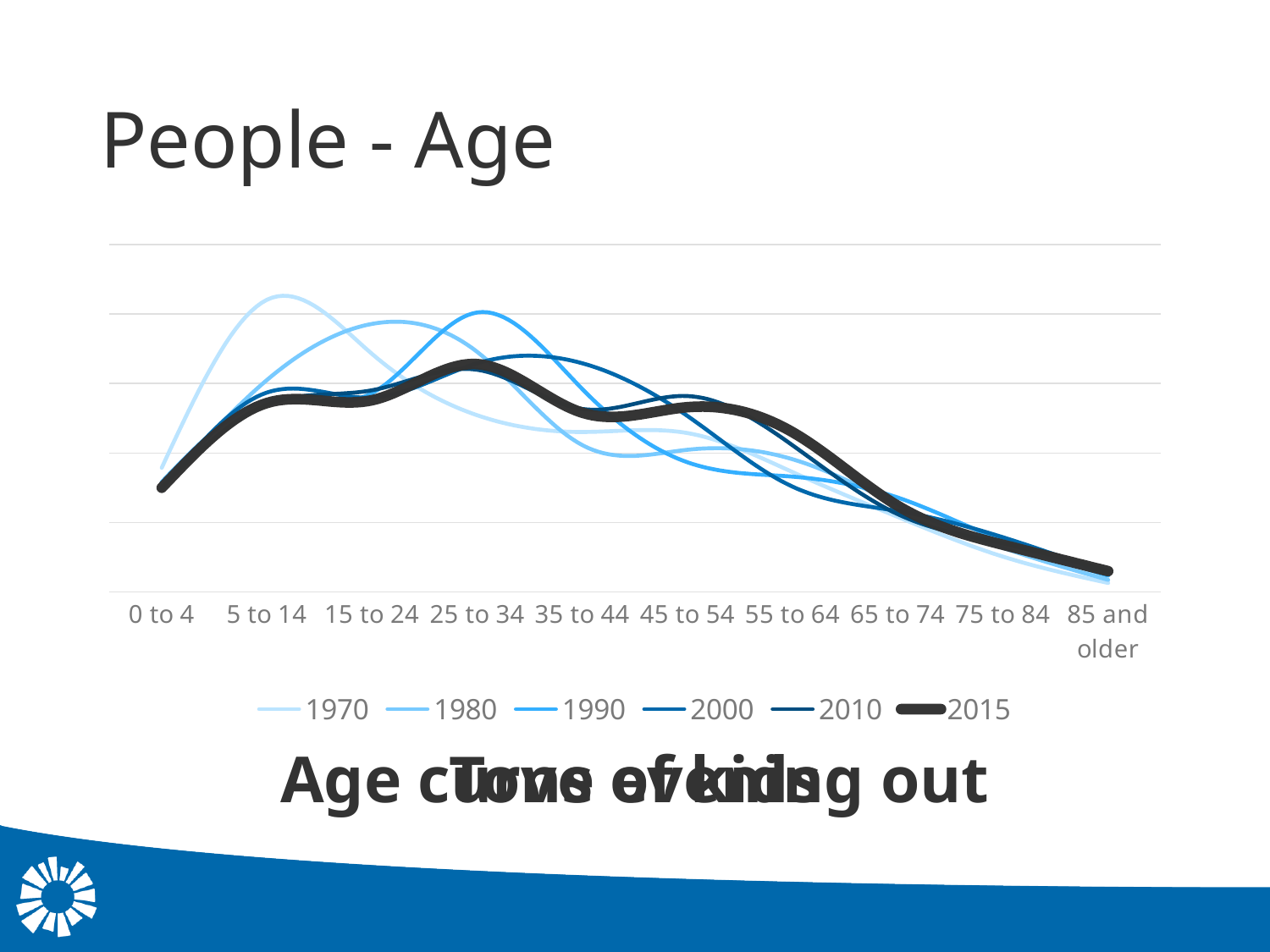
For the 1990 series, which age category has the highest value? 25 to 34 For the 2015 series, which age category has the lowest value? 85 and older For the 1970 series, which age category has the highest value? 5 to 14 Which series is drawn with the thick dark line? 2015 Does the 2015 series rise or fall from 55 to 64 through 85 and older? fall How many age categories are shown on the x axis? 10 At the 5 to 14 category, which is higher: the 1970 series or the 2015 series? 1970 How many series does the legend list? 6 What kind of chart is shown on the slide? line chart For the 1980 series, which age category has the highest value? 15 to 24 Which years are listed in the legend? 1970, 1980, 1990, 2000, 2010, 2015